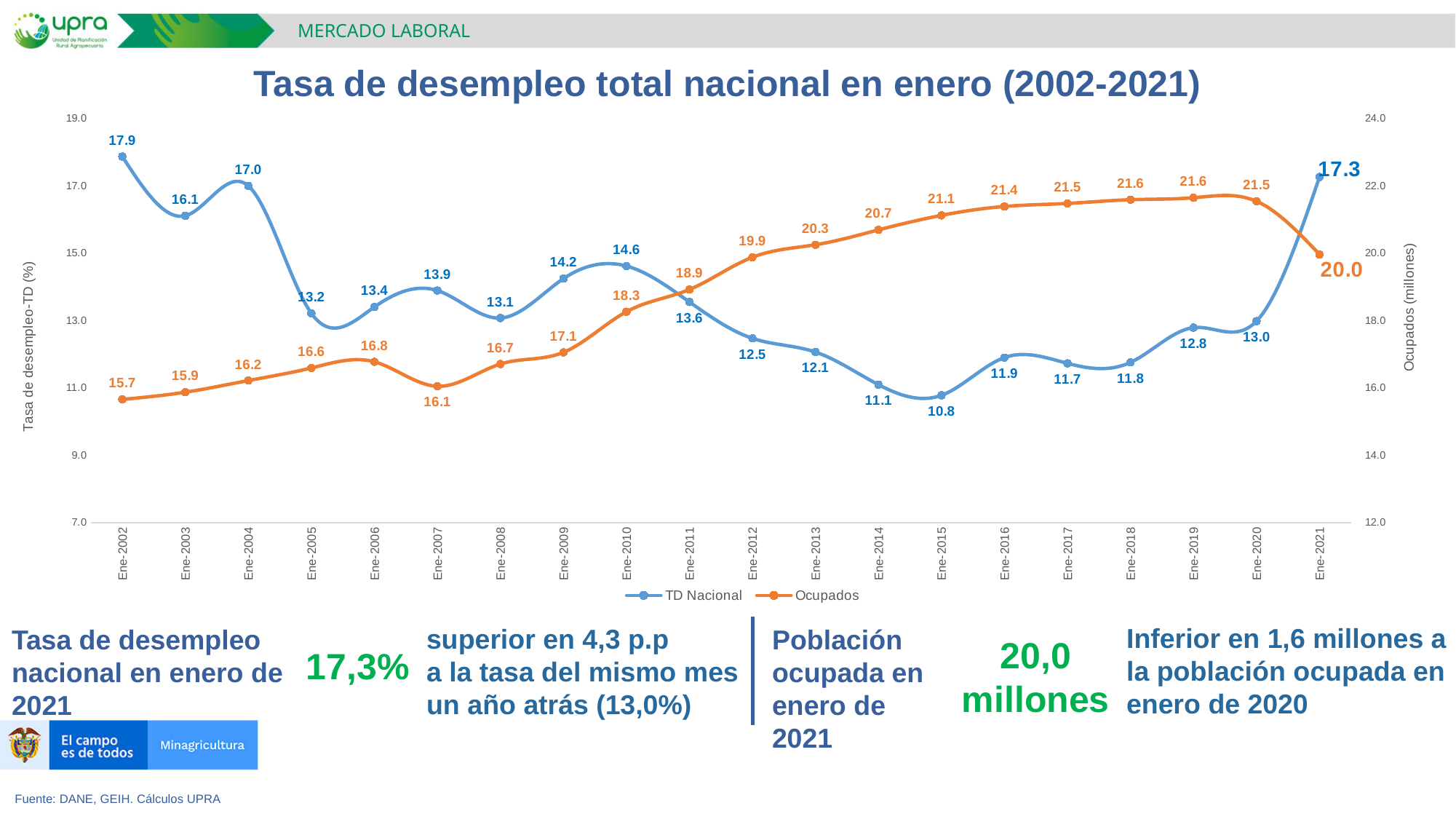
How many data points are plotted for the TD Nacional series? 20 Does the Ocupados series rise or fall between Ene-2011 and Ene-2018? Rise In which year is the Ocupados value lowest? Ene-2002 In which year is the TD Nacional value lowest? Ene-2015 What is the TD Nacional value for Ene-2021? 17.3 Which is larger, the TD Nacional value for Ene-2010 or for Ene-2009? Ene-2010 In which year is the TD Nacional value highest? Ene-2002 What is the difference between the TD Nacional values for Ene-2021 and Ene-2020? 4.3 How many series does the legend list? 2 What is the title of the chart? Tasa de desempleo total nacional en enero (2002-2021) What is the Ocupados value for Ene-2013? 20.3 What type of chart is shown on the slide? Line chart